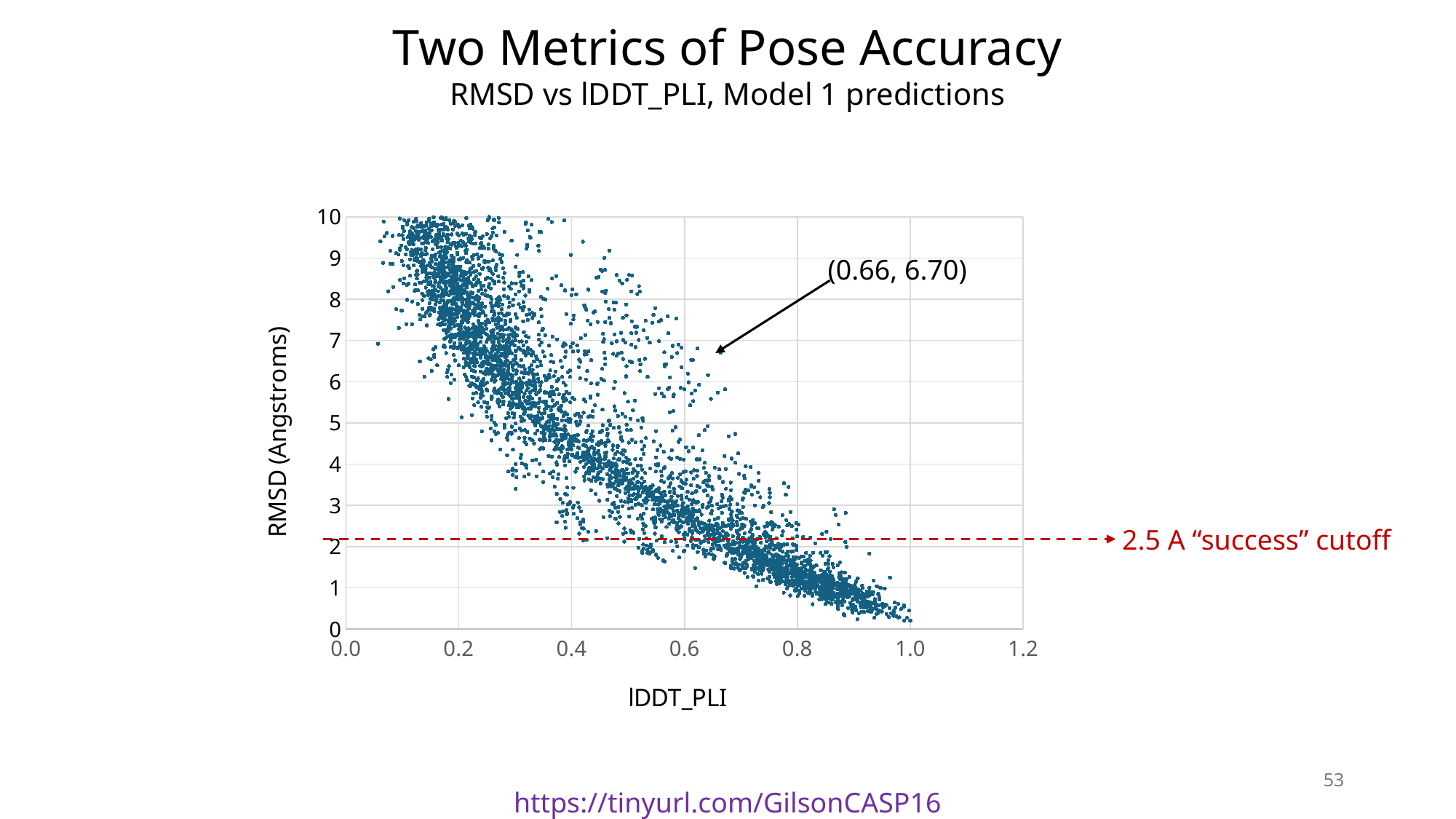
Is the RMSD of the annotated point greater or less than the 2.5 A "success" cutoff? greater What does the red dashed horizontal line on the chart represent? 2.5 A "success" cutoff What kind of chart is shown on the slide? scatter plot What is the highest tick value shown on the x axis? 1.2 As lDDT_PLI increases along the x axis, does RMSD generally rise or fall? fall Is the RMSD of the annotated point (0.66, 6.70) greater or less than 5? greater What is the lDDT_PLI value of the annotated point on the chart? 0.66 What is the highest tick value shown on the y axis? 10 What is the RMSD value of the annotated point on the chart? 6.70 What are the coordinates of the point called out with an arrow on the chart? (0.66, 6.70) What is the label of the y axis? RMSD (Angstroms)